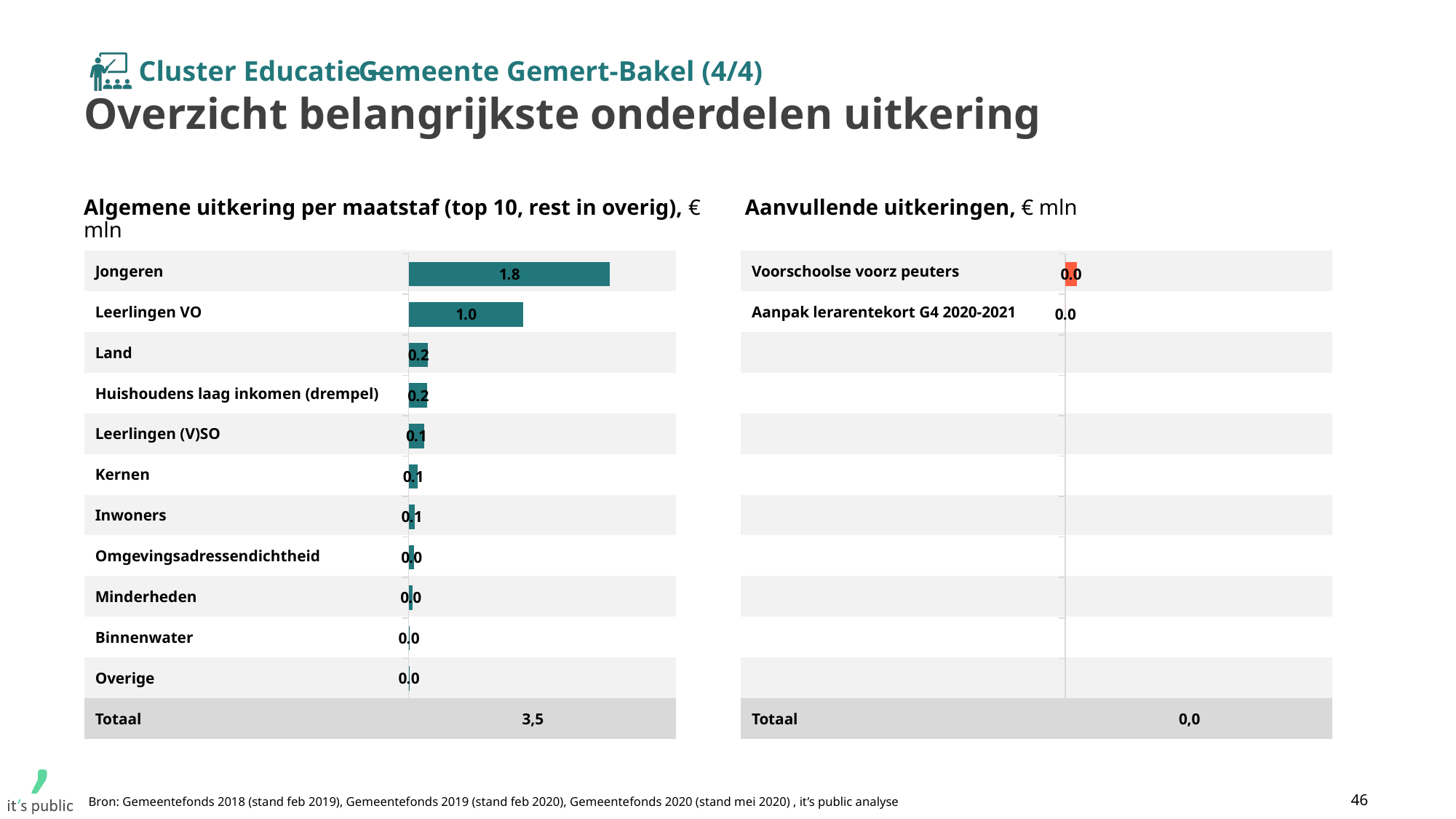
In the chart 'Algemene uitkering per maatstaf', what is the difference between the values for Jongeren and Leerlingen VO? 0.8 How many categories are shown in the chart 'Algemene uitkering per maatstaf'? 11 What kind of chart is 'Algemene uitkering per maatstaf'? Bar chart In the chart 'Algemene uitkering per maatstaf', what is the value for Huishoudens laag inkomen (drempel)? 0.2 In the chart 'Aanvullende uitkeringen', what is the value for Voorschoolse voorz peuters? 0.0 What is the total (Totaal) shown for the chart 'Aanvullende uitkeringen'? 0,0 In the chart 'Algemene uitkering per maatstaf', what is the value for Jongeren? 1.8 What is the total (Totaal) shown for the chart 'Algemene uitkering per maatstaf'? 3,5 In the chart 'Algemene uitkering per maatstaf', which is larger: the value for Leerlingen VO or the value for Land? Leerlingen VO How many categories are shown in the chart 'Aanvullende uitkeringen'? 2 In the chart 'Algemene uitkering per maatstaf', what is the value for Leerlingen VO? 1.0 In the chart 'Algemene uitkering per maatstaf', which category has the highest value? Jongeren